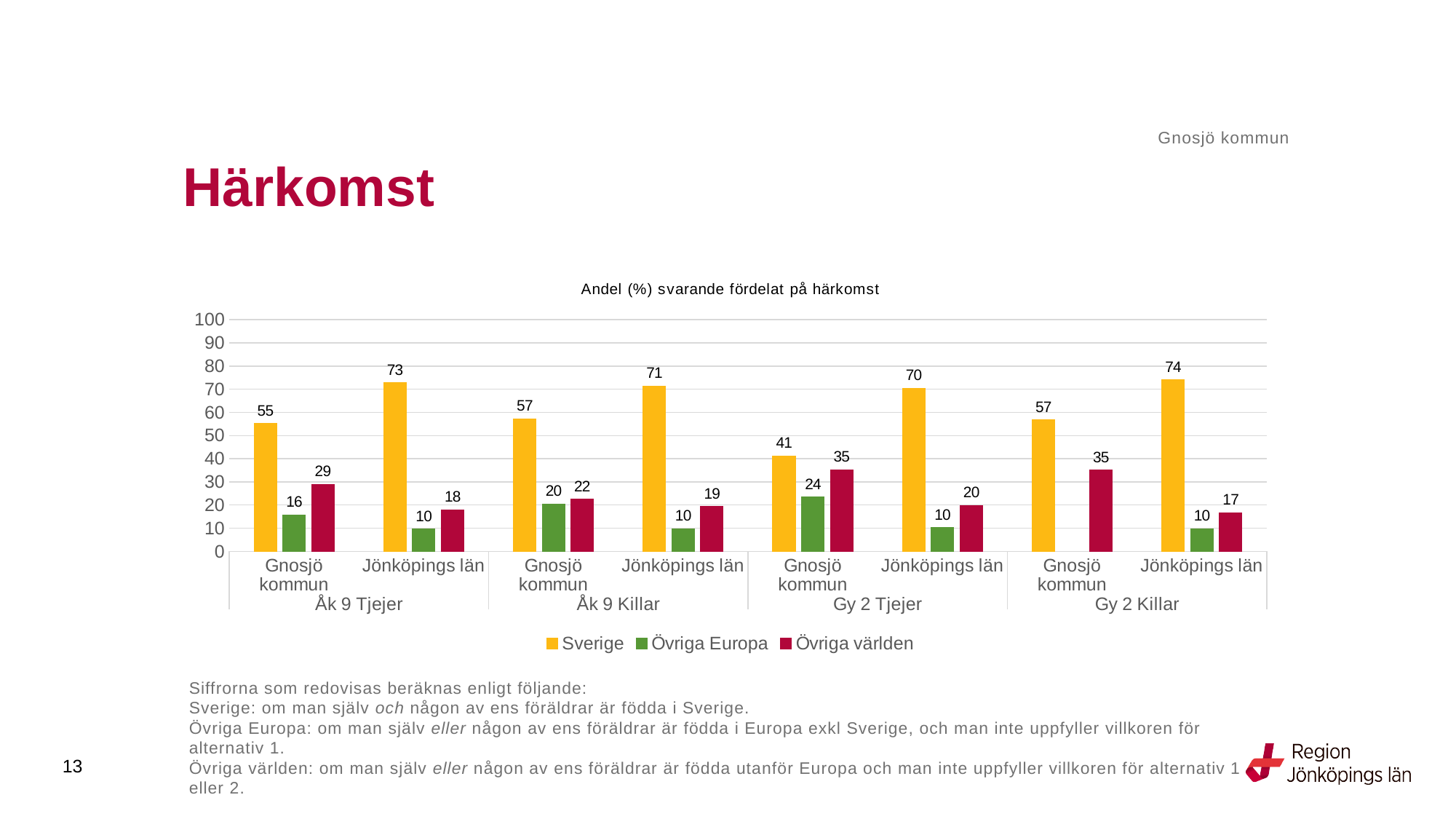
What is the Sverige value for Gnosjö kommun in the Åk 9 Tjejer group? 55 What kind of chart is shown on the slide? bar chart Which category has the highest Sverige value? Jönköpings län (Gy 2 Killar) Is the Sverige value for Gnosjö kommun in the Gy 2 Tjejer group greater or less than 50? less In the Gy 2 Tjejer group, which is larger for Gnosjö kommun: Övriga Europa or Övriga världen? Övriga världen What is the title of the chart? Andel (%) svarande fördelat på härkomst How many series does the legend list? 3 What is the Övriga Europa value for Jönköpings län in the Åk 9 Killar group? 10 What is the difference between the Sverige values for Jönköpings län and Gnosjö kommun in the Åk 9 Tjejer group? 18 What is the Övriga världen value for Gnosjö kommun in the Gy 2 Tjejer group? 35 Which colour represents the Övriga Europa series? green Which category has the lowest Sverige value? Gnosjö kommun (Gy 2 Tjejer)